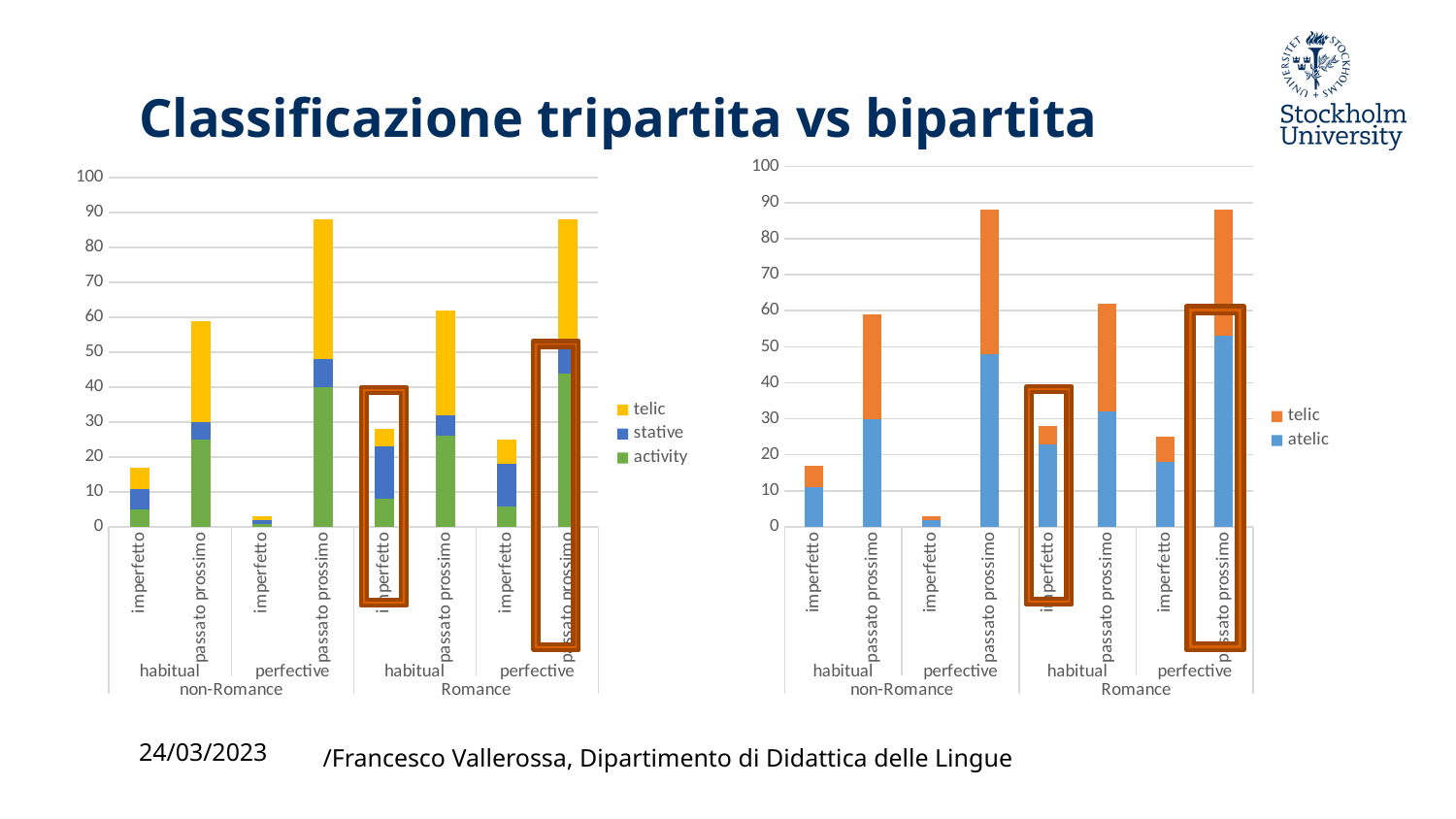
In the left chart, which bar has the lowest total? imperfetto, perfective, non-Romance What kind of chart is the left chart on the slide? stacked bar chart In the right chart, is the total for imperfetto under perfective Romance greater or less than 20? greater In the right chart, is the total for passato prossimo under perfective Romance greater or less than 80? greater In the left chart, is the total for imperfetto under habitual non-Romance greater or less than 20? less How many series does the legend of the right chart list? 2 How many series does the legend of the left chart list? 3 How many bars are plotted in the left chart? 8 In the right chart, what are the two legend entries? telic, atelic In the left chart, which bar is taller: passato prossimo under habitual non-Romance or imperfetto under habitual non-Romance? passato prossimo under habitual non-Romance What is the title of the slide? Classificazione tripartita vs bipartita